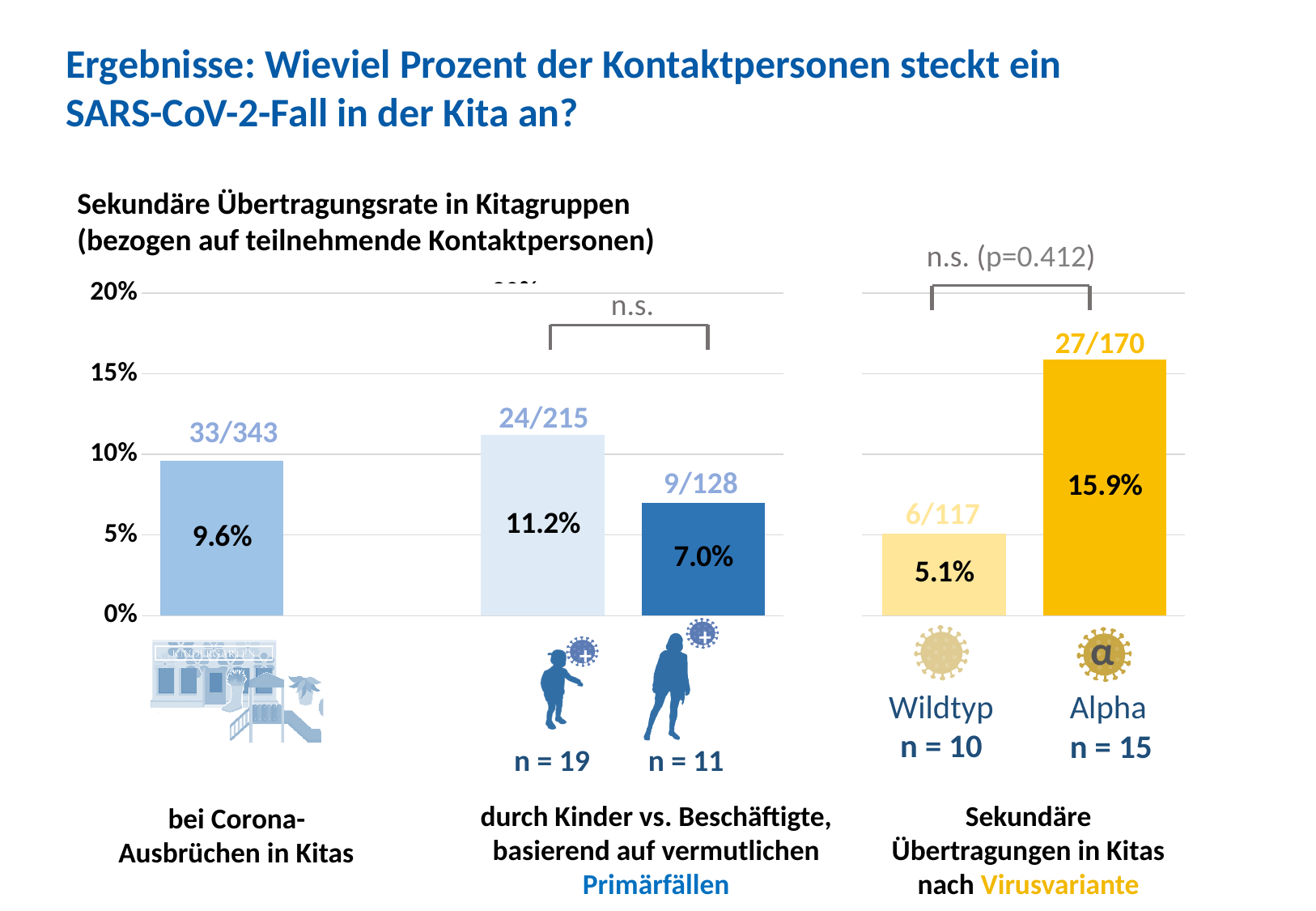
What kind of chart is used on this slide? bar chart In the middle chart (durch Kinder vs. Beschäftigte), what is the transmission rate for the Beschäftigte bar? 7.0% In the left chart (bei Corona-Ausbrüchen in Kitas), what fraction is printed above the bar? 33/343 In the right chart (nach Virusvariante), what fraction is printed above the Wildtyp bar? 6/117 In the right chart (nach Virusvariante), what is the n value shown for Alpha? n = 15 In the left chart (bei Corona-Ausbrüchen in Kitas), what is the secondary transmission rate shown on the bar? 9.6% In the middle chart (durch Kinder vs. Beschäftigte), what is the transmission rate for the Kinder bar? 11.2% In the right chart (nach Virusvariante), is the value for Wildtyp greater or less than 10%? less In the right chart (nach Virusvariante), which variant has the higher transmission rate? Alpha In the right chart (nach Virusvariante), what is the transmission rate for Alpha? 15.9% In the middle chart (durch Kinder vs. Beschäftigte), what is the difference between the Kinder rate and the Beschäftigte rate? 4.2% In the right chart (nach Virusvariante), what is the difference between the Alpha rate and the Wildtyp rate? 10.8%